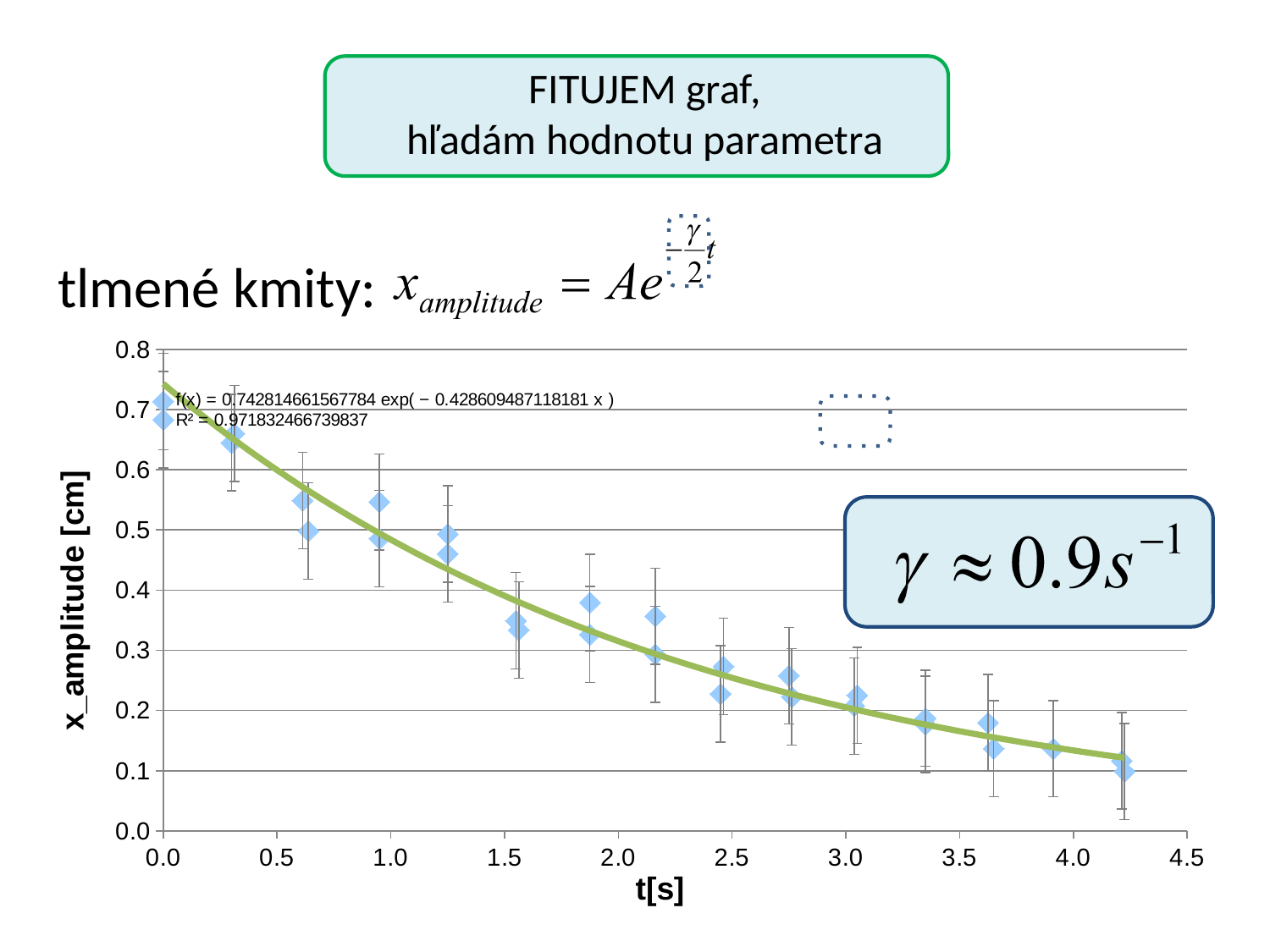
Which is larger, the plotted amplitude at t ≈ 0.3 or at t ≈ 2.5? t ≈ 0.3 What fitted function f(x) is printed on the chart? f(x) = 0.742814661567784 exp( − 0.428609487118181 x ) What is the label of the vertical axis of the chart? x_amplitude [cm] Is the plotted amplitude at t = 0.0 greater or less than 0.5? greater What is the label of the horizontal axis of the chart? t[s] What kind of chart is shown on the slide? scatter chart Is the plotted amplitude at t ≈ 1.25 greater or less than 0.6? less Do the plotted amplitude values rise or fall as t increases along the x axis? fall Is the plotted amplitude at t ≈ 3.0 greater or less than 0.3? less What R² value is printed on the chart for the fitted curve? R² = 0.971832466739837 At which value of t is the highest plotted amplitude found? 0.0